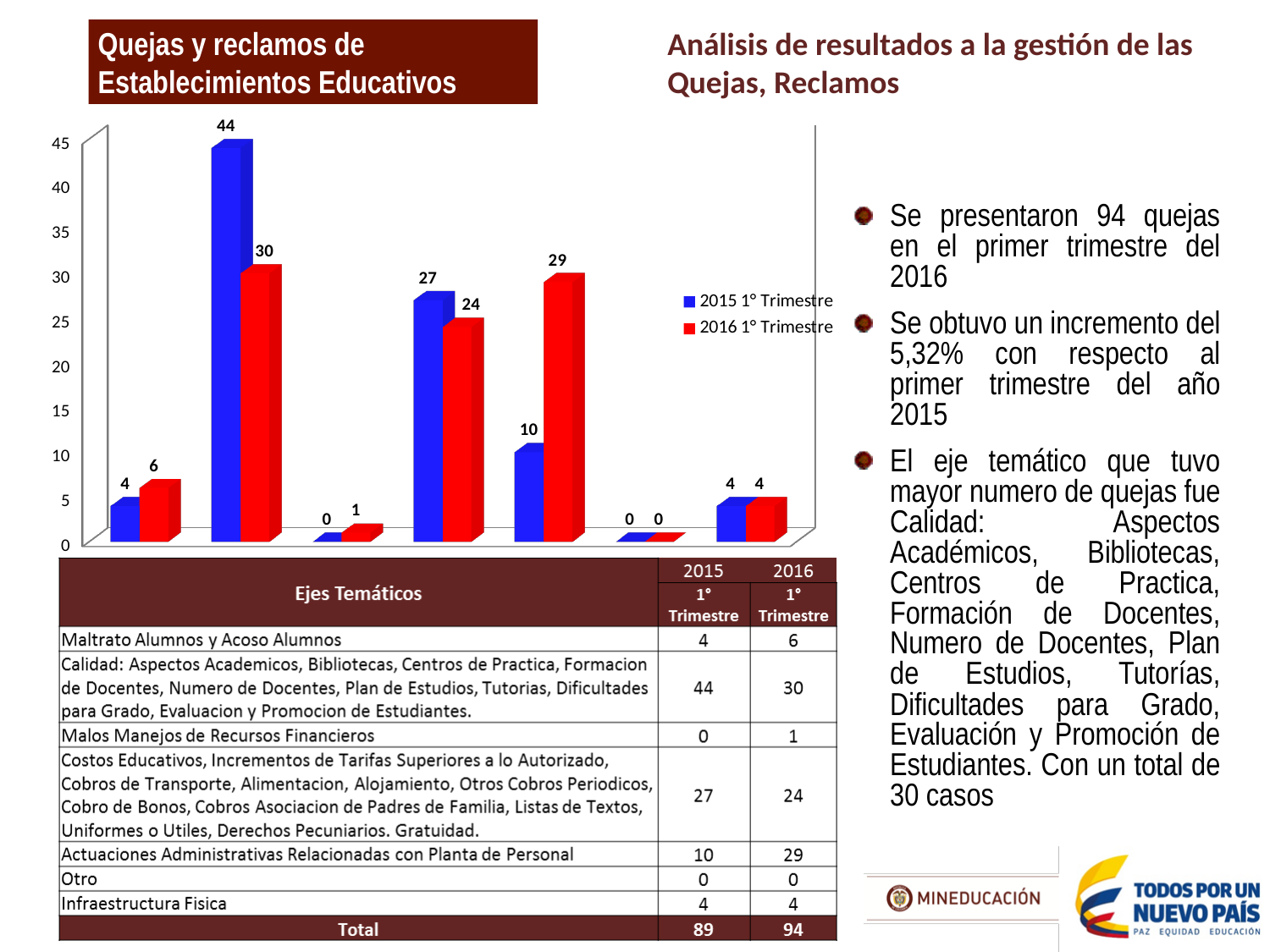
What is the 2016 1° Trimestre value for Malos Manejos de Recursos Financieros (third group of bars)? 1 What is the 2015 1° Trimestre value for the first group of bars (Maltrato Alumnos y Acoso Alumnos)? 4 What kind of chart is shown on the slide? bar chart What is the highest value in the 2015 1° Trimestre series? 44 What colour represents the 2016 1° Trimestre series in the chart? red For the fifth group of bars (Actuaciones Administrativas), which series has the larger value, 2015 1° Trimestre or 2016 1° Trimestre? 2016 1° Trimestre What is the difference between the 2015 and 2016 values for the second group of bars (Calidad: Aspectos Academicos...)? 14 How many series does the chart legend list? 2 Is the 2016 1° Trimestre value for the second group of bars (Calidad) greater or less than 25? greater What is the 2016 1° Trimestre value for Actuaciones Administrativas Relacionadas con Planta de Personal (fifth group of bars)? 29 What is the difference between the 2015 and 2016 values for the fourth group of bars (Costos Educativos...)? 3 How many groups of bars (categories) are plotted in the chart? 7